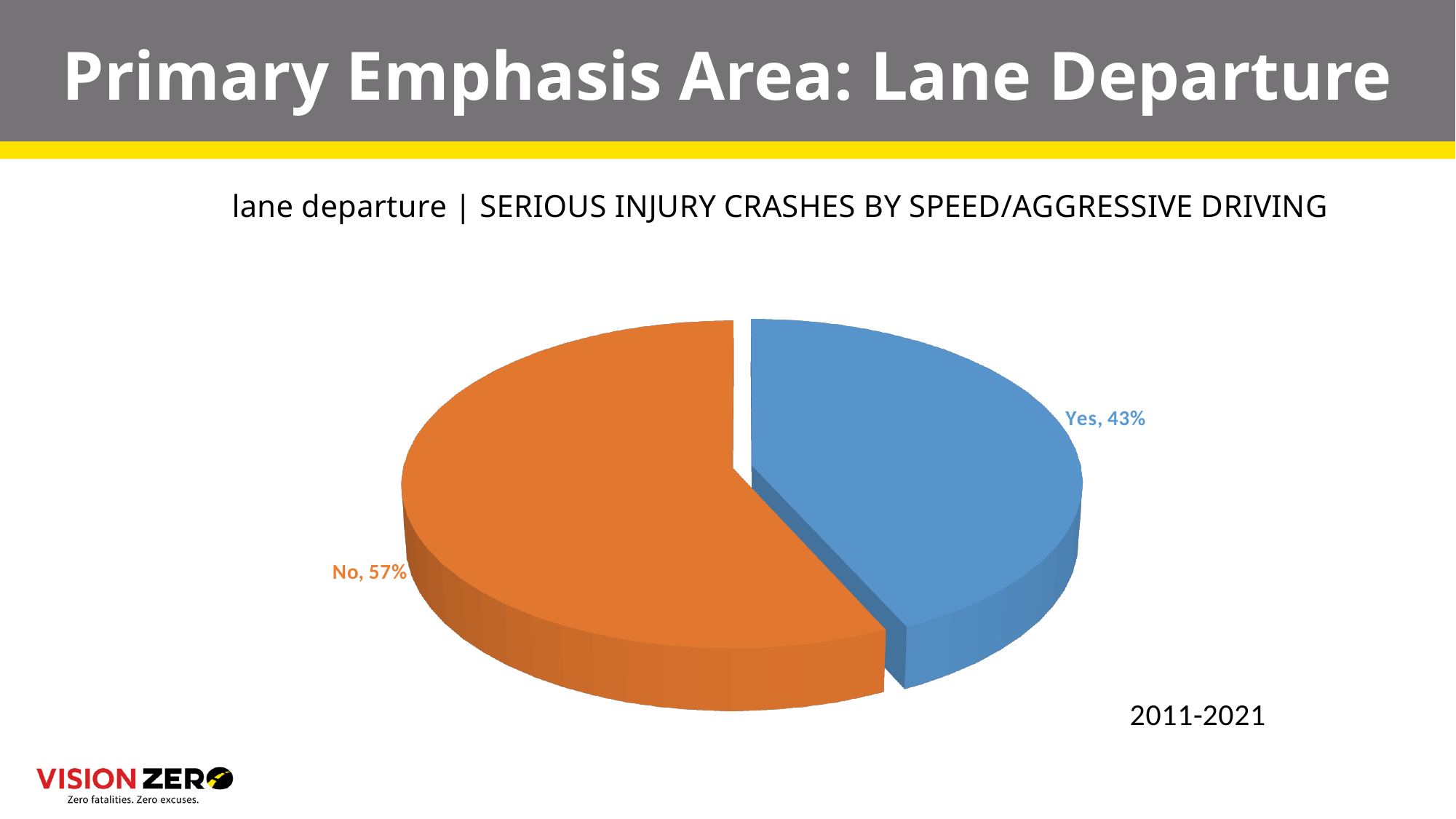
What kind of chart is shown on the slide? Pie chart What year range is shown beneath the chart? 2011-2021 How many slices does the pie chart have? 2 What share of the pie is labelled "Yes"? 43% What colour is the "Yes" slice of the pie? Blue What is the difference in percentage points between the "No" slice and the "Yes" slice? 14 Which slice of the pie is the smallest? Yes What is the title of the chart? lane departure | SERIOUS INJURY CRASHES BY SPEED/AGGRESSIVE DRIVING What is the total of the two slice percentages shown on the pie? 100% What share of the pie is labelled "No"? 57% Which slice of the pie is the largest? No Which slice is larger, "Yes" or "No"? No